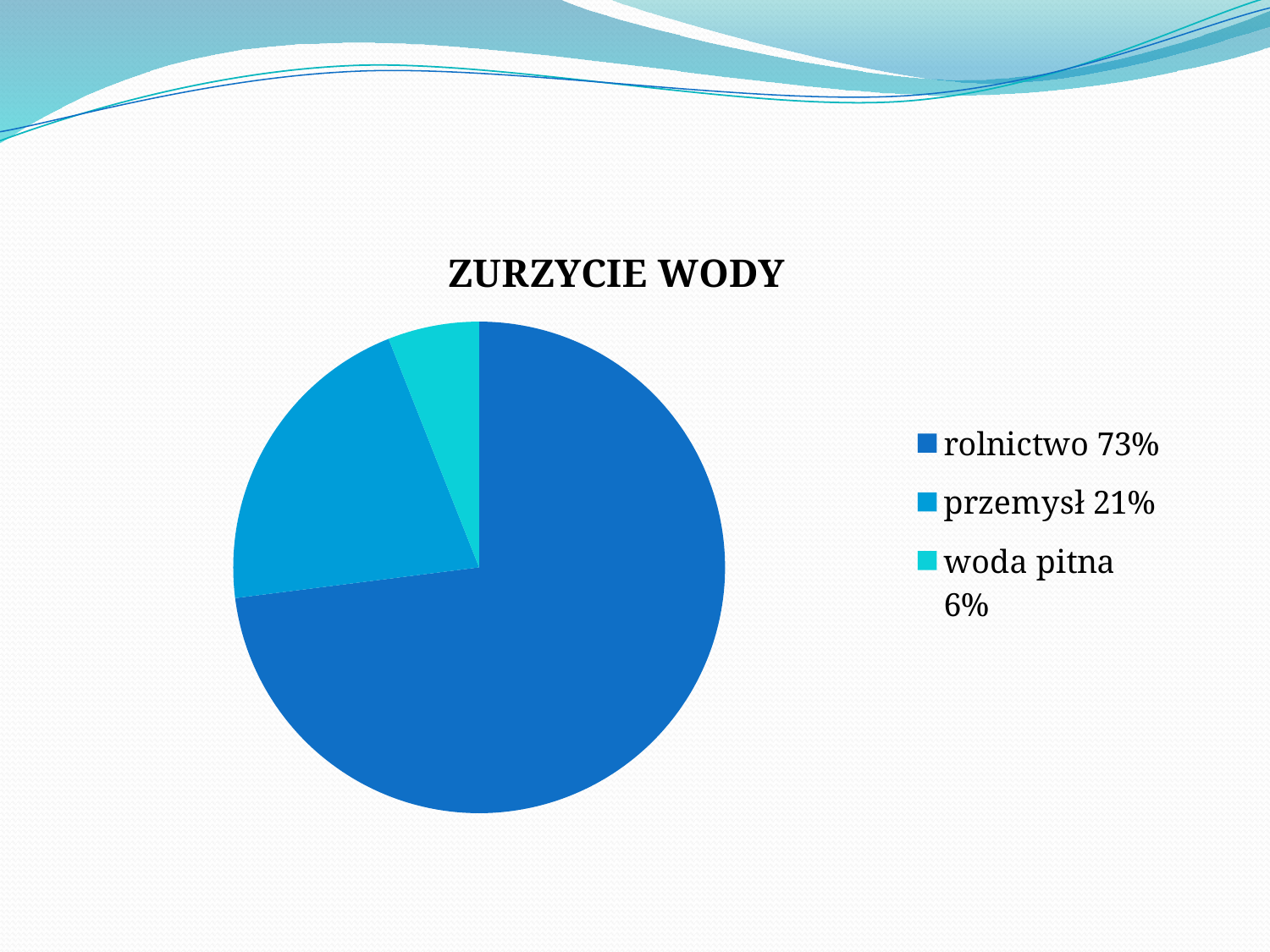
Which category has the largest share of the pie? rolnictwo What kind of chart is shown on the slide? pie chart What is the difference in percentage points between rolnictwo and przemysł? 52 How many categories does the pie chart have? 3 What is the title of the chart? ZURZYCIE WODY What share of the pie does przemysł have? 21% Which category has the smallest share of the pie? woda pitna Which is larger, the share for przemysł or the share for woda pitna? przemysł How many entries does the legend list? 3 What share of the pie does rolnictwo have? 73% What share of the pie does woda pitna have? 6% What is the difference in percentage points between przemysł and woda pitna? 15